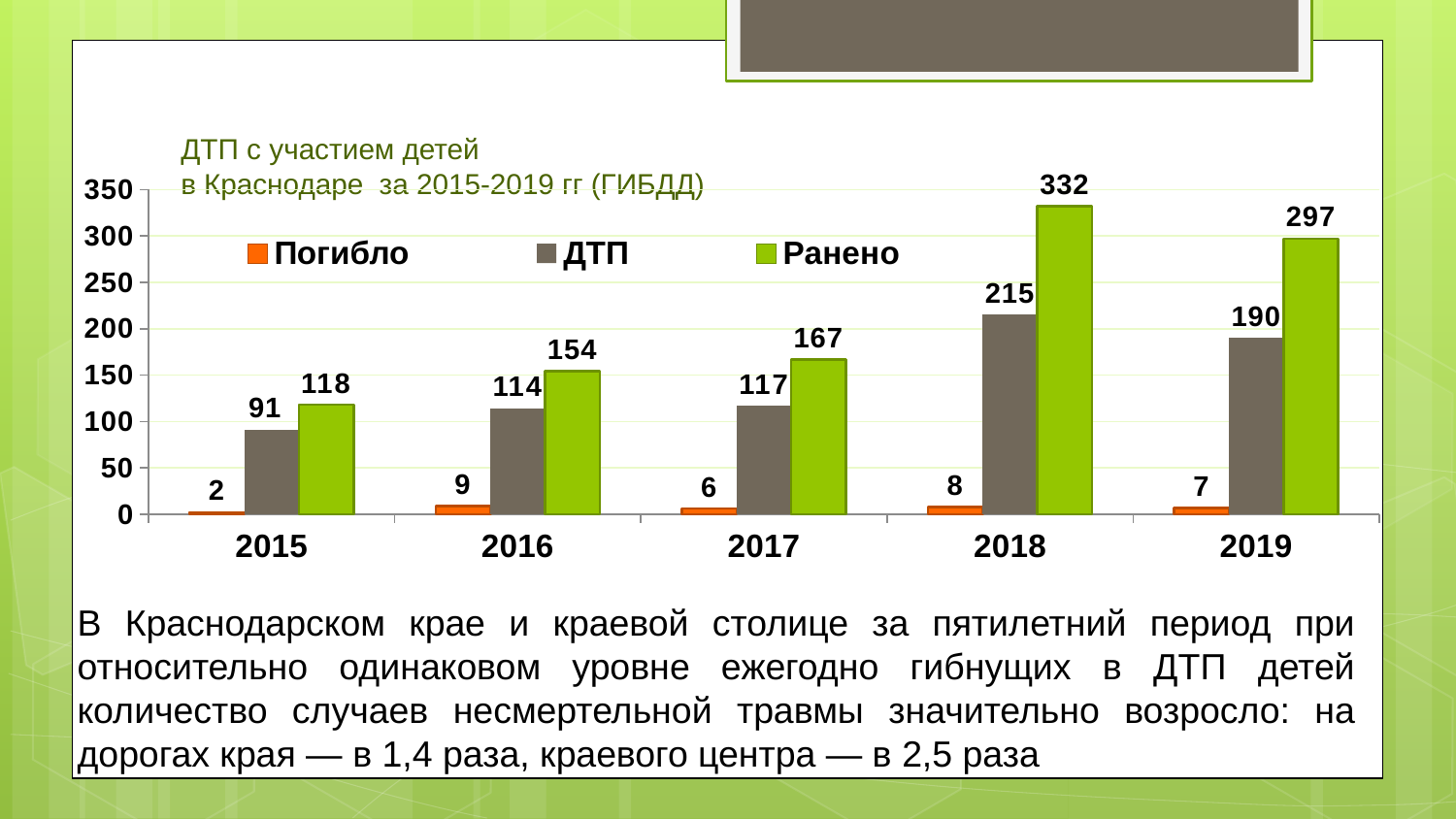
How many series does the legend list? 3 What is the value for ДТП in 2016? 114 In which year is the Погибло value lowest? 2015 What kind of chart is shown on the slide? Bar chart In which year is the Ранено value highest? 2018 What is the value for Погибло in 2015? 2 Does the ДТП value rise or fall from 2015 to 2018? Rise What is the value for Ранено in 2018? 332 Which series is shown in green? Ранено Which is larger, the ДТП value for 2017 or for 2019? 2019 What is the difference between the Ранено values for 2018 and 2019? 35 How many years are shown on the x axis? 5